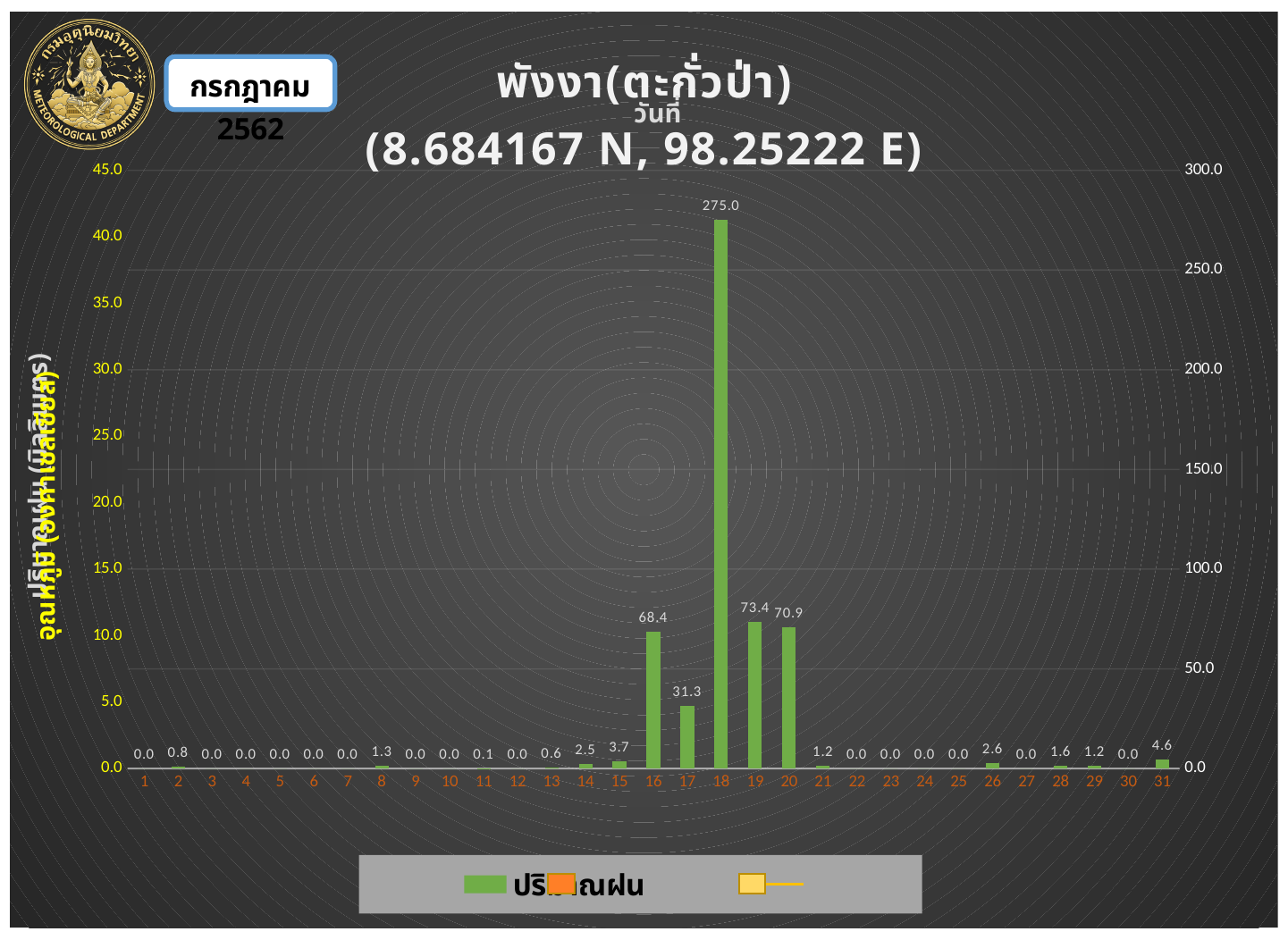
What kind of chart is shown on the slide? bar chart Which day has the highest value? 18 What is the value for day 16? 68.4 What is the value for day 17? 31.3 Is the value for day 18 greater or less than 250.0 on the right axis? greater What is the difference between the values for day 16 and day 17? 37.1 What coordinates are given in the chart title? 8.684167 N, 98.25222 E What is the value for day 18? 275.0 Which is larger, the value for day 19 or the value for day 20? day 19 What is the difference between the values for day 19 and day 20? 2.5 What is the value for day 31? 4.6 How many days are shown on the x axis? 31